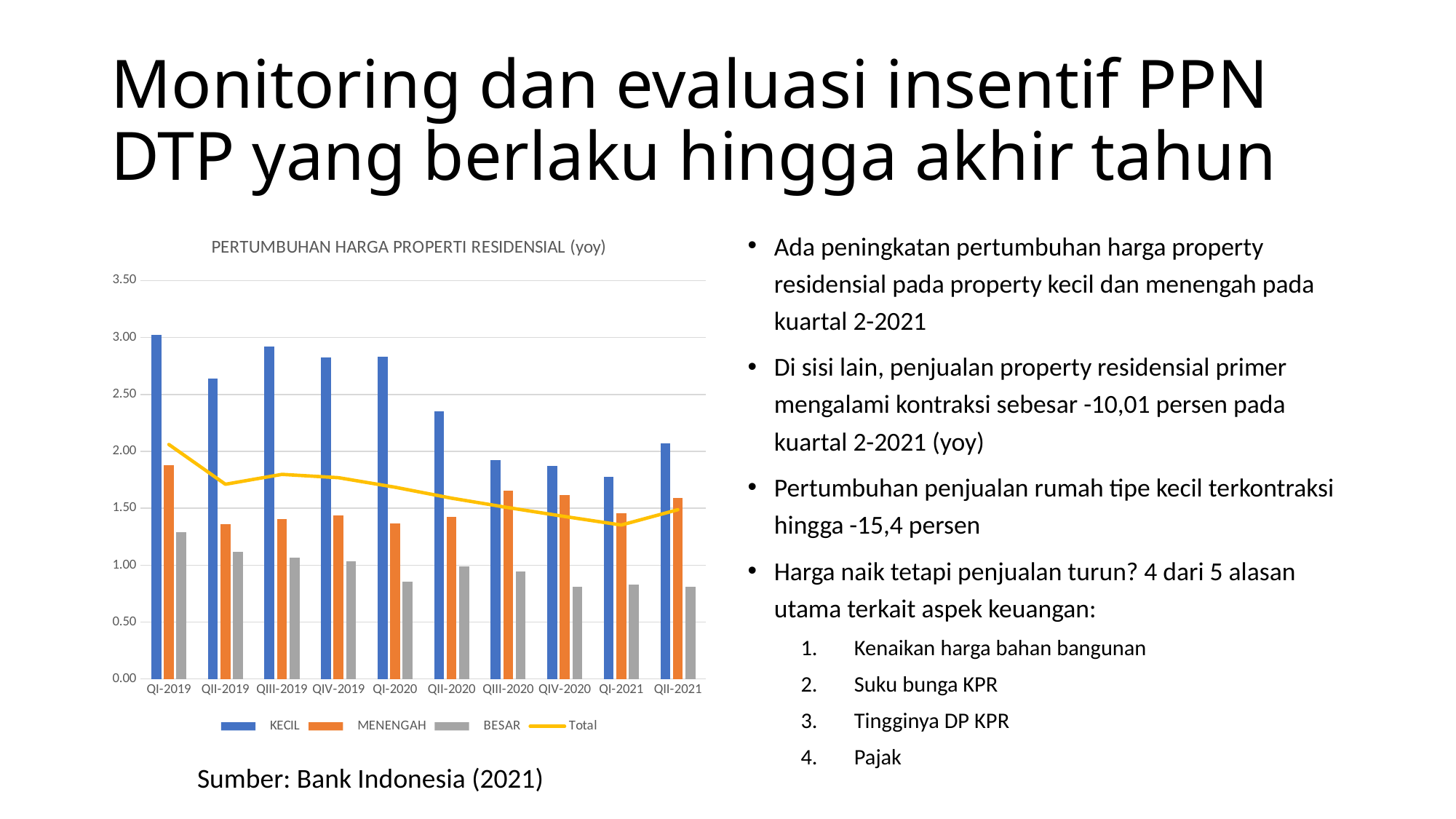
In which quarter is the KECIL bar highest? QI-2019 Is the KECIL value for QII-2020 greater or less than 2.00? greater How many series does the legend list? 4 Is the BESAR value for QIV-2020 greater or less than 1.00? less In which quarter is the MENENGAH bar highest? QI-2019 What kind of chart is shown on the slide? A bar chart with a line for Total How many quarters are shown on the x axis? 10 What is the title of the chart? PERTUMBUHAN HARGA PROPERTI RESIDENSIAL (yoy) In which quarter is the KECIL bar lowest? QI-2021 In QII-2021, which is larger: the KECIL bar or the MENENGAH bar? KECIL Does the Total line generally rise or fall from QI-2019 to QI-2021? fall In which quarter is the BESAR bar highest? QI-2019